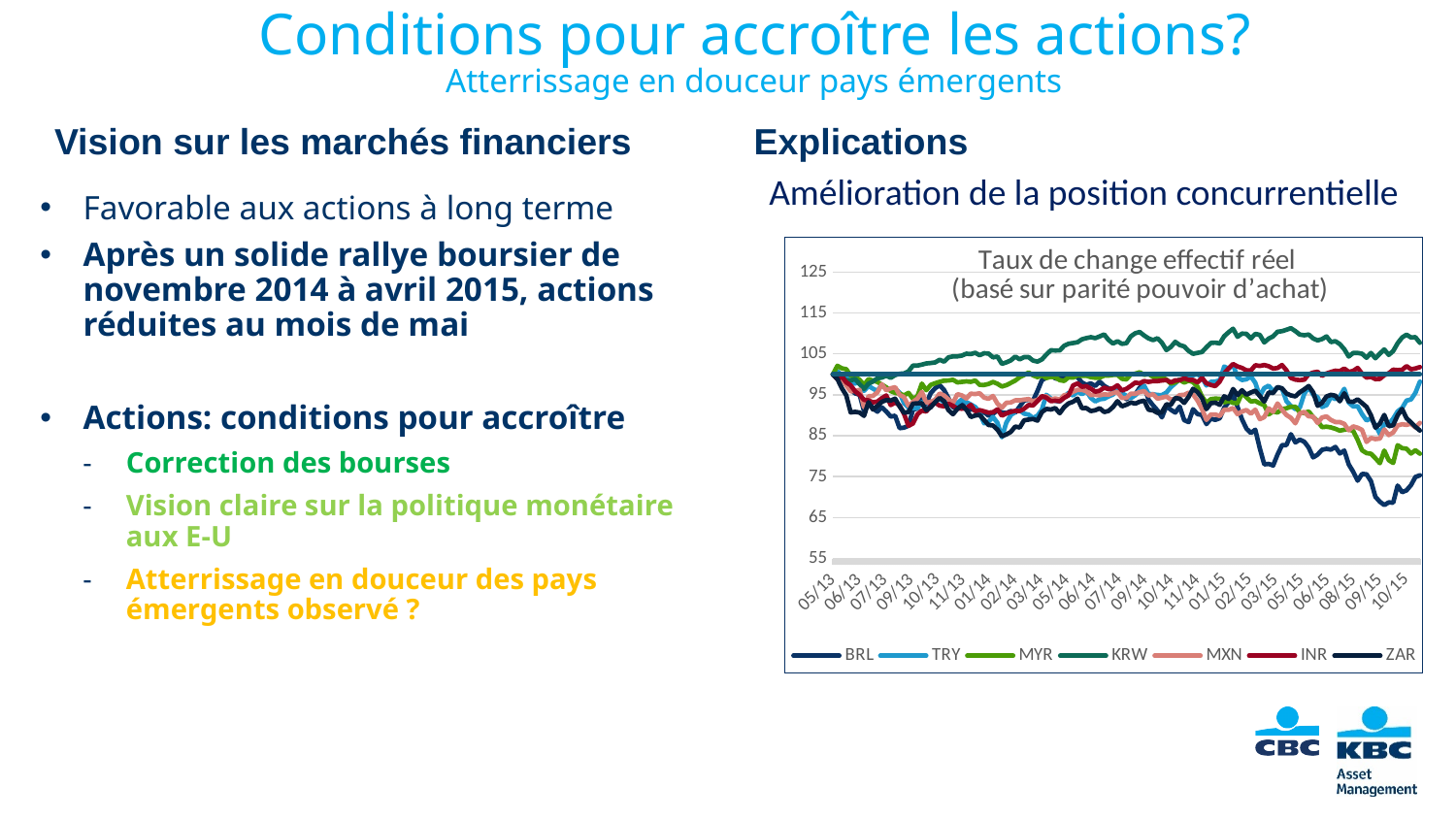
How many series does the chart's legend list? 7 At 10/15, which is larger, the value for KRW or the value for BRL? KRW What kind of chart is shown on the slide? line chart Is the value for MYR at 10/15 greater or less than 85? less Is the value for KRW in 03/15 greater or less than 105? greater Which currencies are listed in the chart's legend? BRL, TRY, MYR, KRW, MXN, INR, ZAR What is the title of the chart on the slide? Taux de change effectif réel (basé sur parité pouvoir d'achat) Which series is the highest at the end of the period (10/15)? KRW Is the lowest value reached by BRL in 2015 greater or less than 75? less Does the KRW series generally rise or fall from 05/13 to 10/15? rise Does the BRL series generally rise or fall from 05/13 to 10/15? fall Which series is the lowest at the end of the period (10/15)? BRL